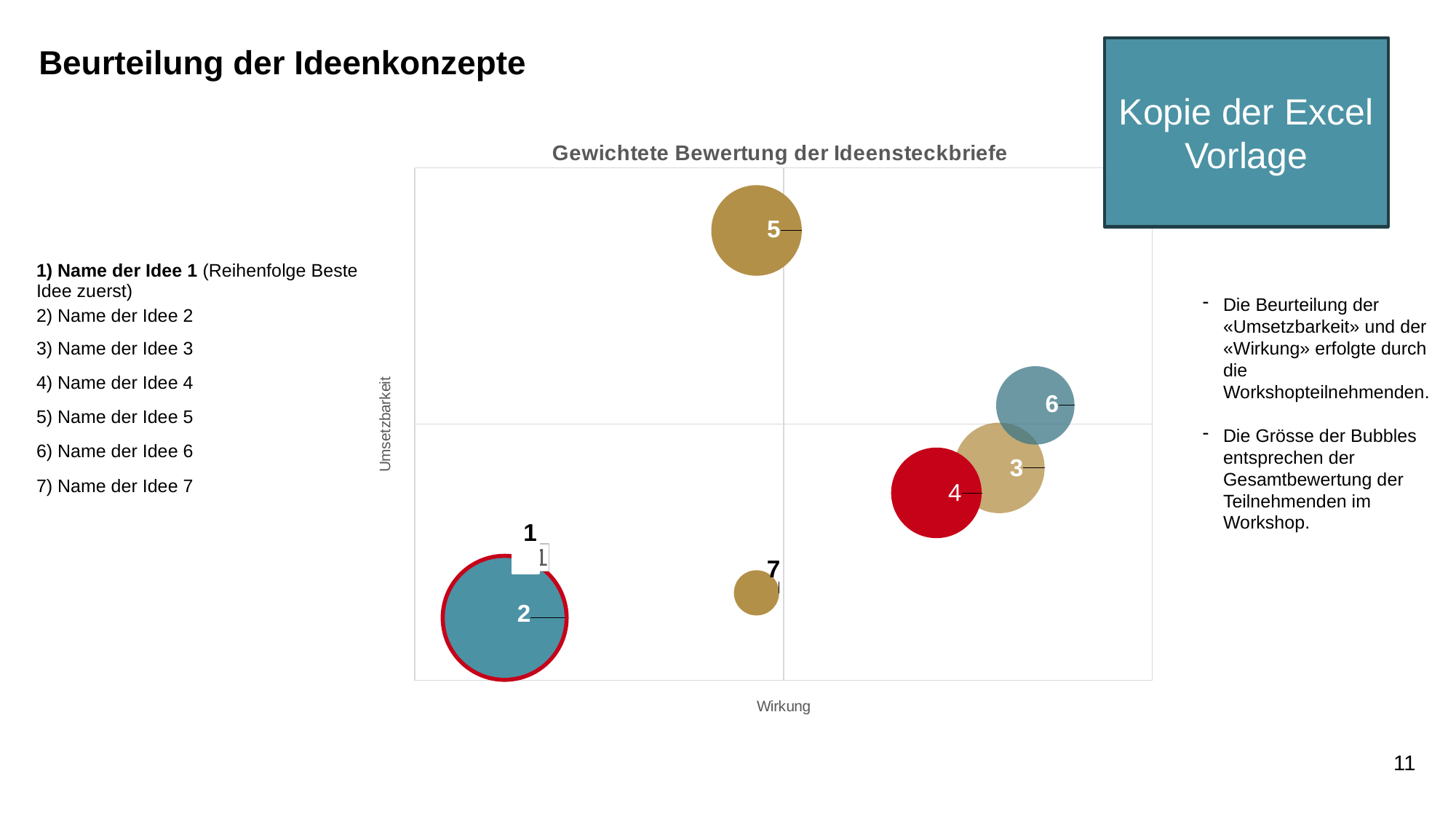
Which bubble is positioned higher on the Umsetzbarkeit axis, bubble 6 or bubble 4? 6 What is the label of the horizontal axis of the chart? Wirkung Which bubble is positioned furthest to the left on the Wirkung axis? 2 Which bubble is larger, bubble 4 or bubble 7? 4 How many bubbles (ideas) are plotted in the chart? 7 Which bubble is positioned highest on the Umsetzbarkeit axis? 5 Which bubble is the largest in the chart? 2 Which bubble is positioned lower on the Umsetzbarkeit axis, bubble 2 or bubble 5? 2 Which bubble is positioned furthest to the right on the Wirkung axis? 6 What kind of chart is shown on the slide? bubble chart What is the title of the chart? Gewichtete Bewertung der Ideensteckbriefe